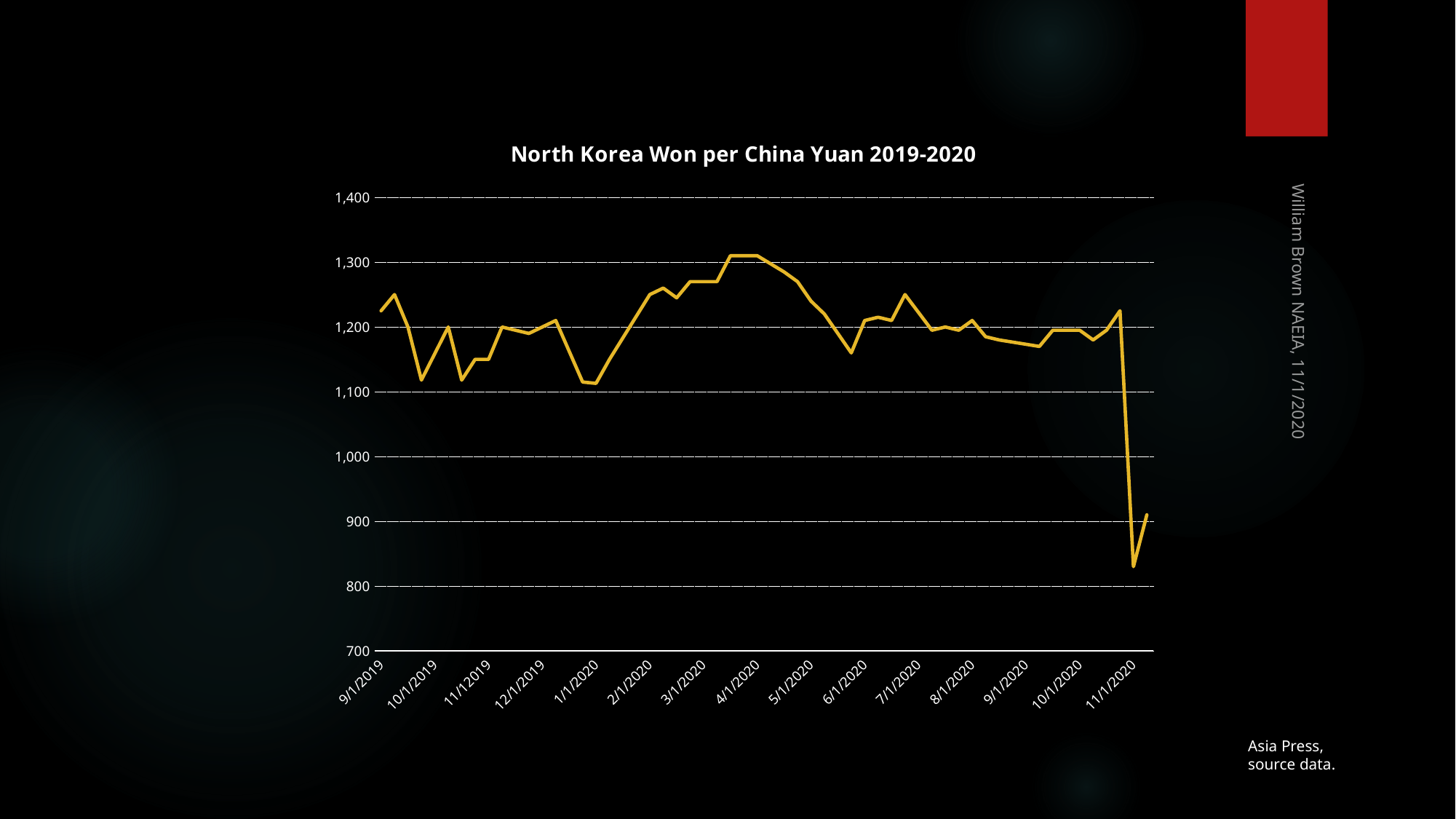
What is the title of the chart? North Korea Won per China Yuan 2019-2020 Is the value at 1/1/2020 greater or less than 1,200? less Around which x-axis date does the line reach its highest value? 4/1/2020 How many lines (series) are plotted on the chart? 1 Comparing the start of the line at 9/1/2019 with its end after 11/1/2020, does the value rise or fall overall? fall What kind of chart is shown on the slide? line chart Is the value at 4/1/2020 greater or less than 1,300? greater Which is larger, the value at 4/1/2020 or the value at 6/1/2020? 4/1/2020 Is the value at 9/1/2019 greater or less than 1,200? greater How many date labels are shown along the x axis? 15